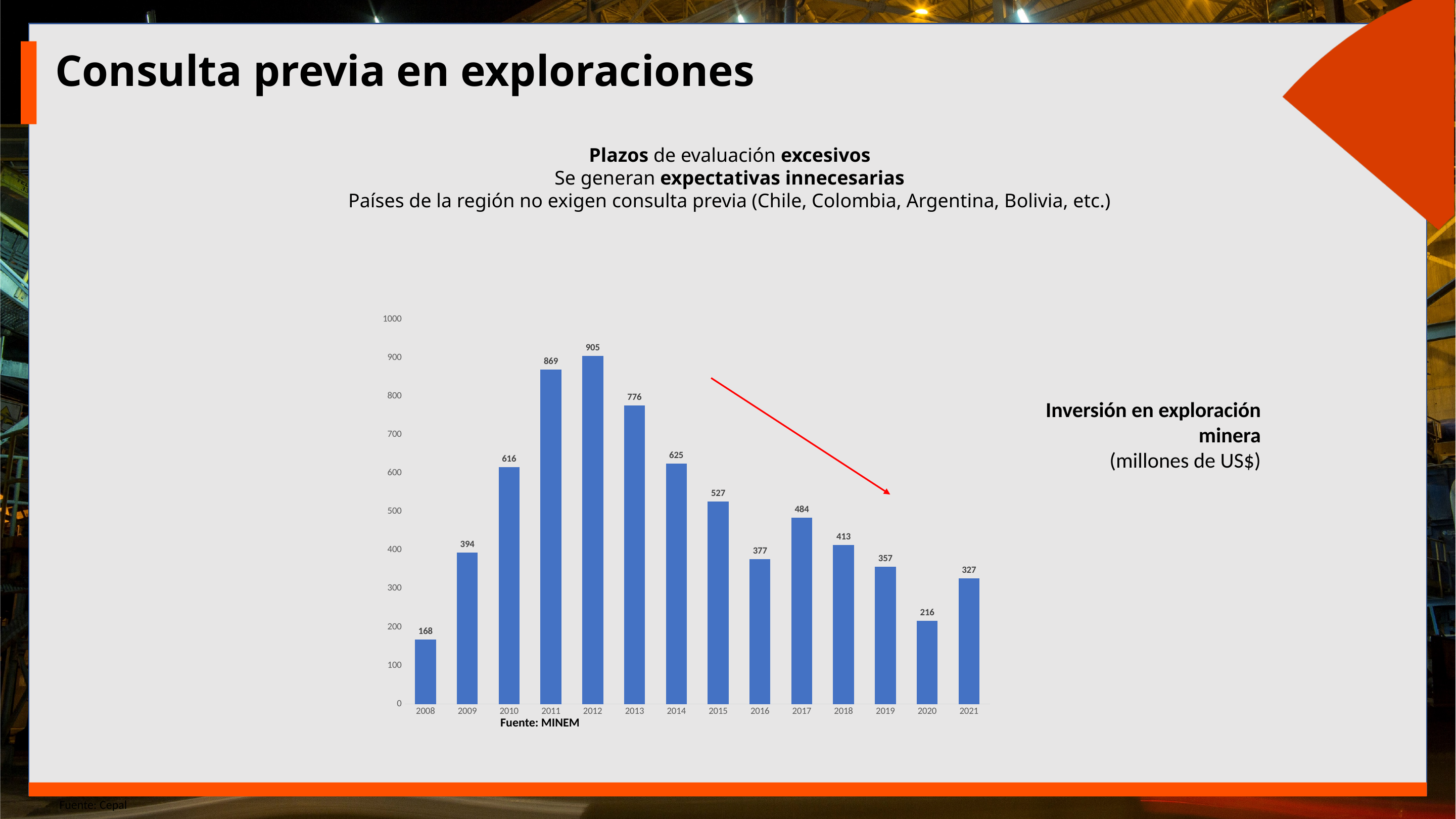
How many years are shown on the x axis? 14 Which year has the highest value? 2012 What is the value for 2020? 216 Is the value for 2013 greater or less than 700? greater What source is cited below the chart? MINEM Which year has the lowest value? 2008 What kind of chart is shown? bar chart Do the values rise or fall from 2012 to 2016? fall What is the value for 2012? 905 What is the value for 2008? 168 What is the difference between the values for 2012 and 2021? 578 Which is larger, the value for 2015 or the value for 2017? 2015